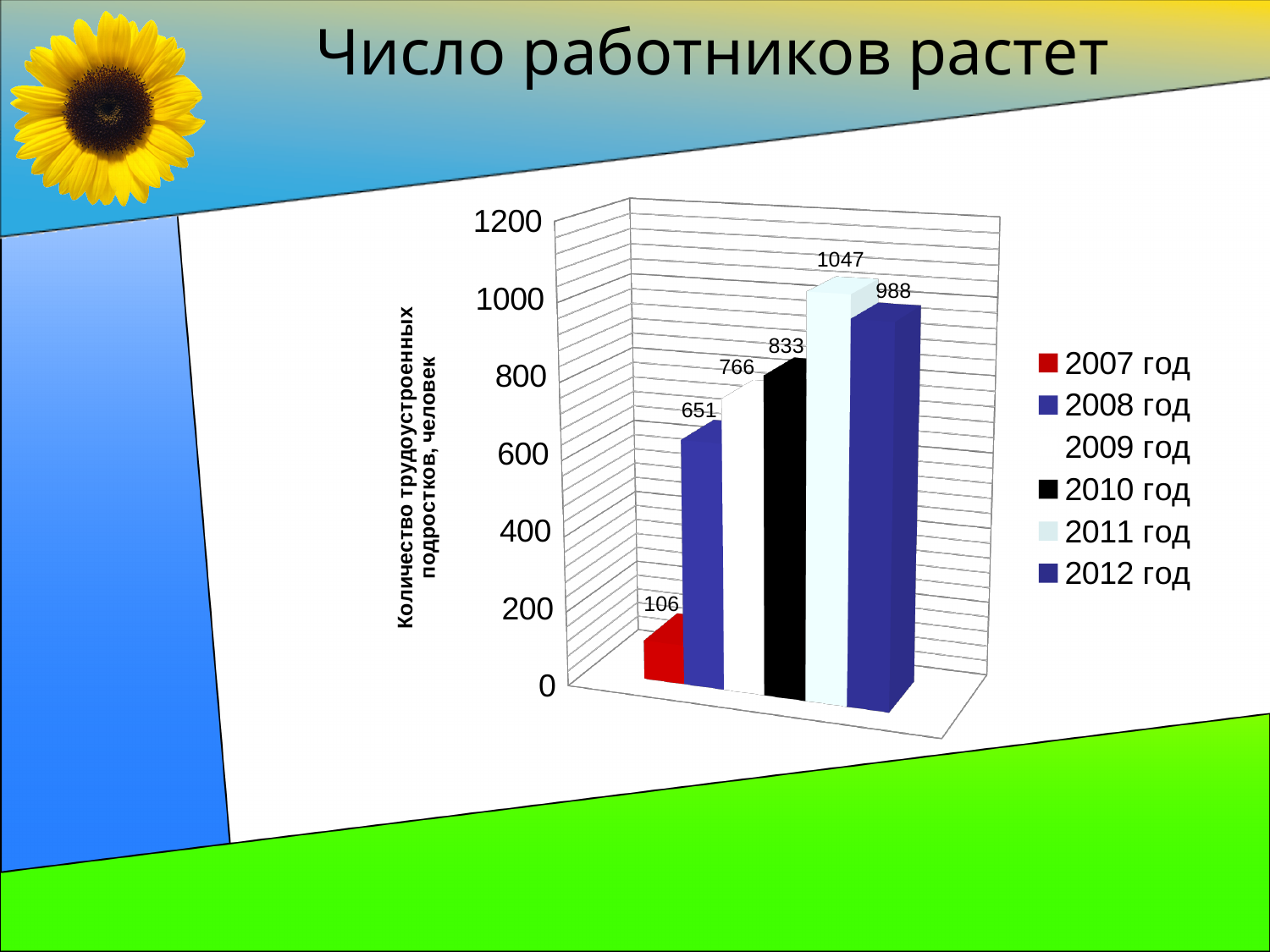
What kind of chart is shown on the slide? bar chart Is the value for 2010 год greater or less than 800? greater Which is larger, the value for 2010 год or the value for 2012 год? 2012 год Which year has the lowest value? 2007 год What is the value for 2009 год? 766 What colour is the bar for 2010 год? black What is the value for 2007 год? 106 What is the title of the slide? Число работников растет What is the value for 2011 год? 1047 What is the difference between the values for 2012 год and 2008 год? 337 Which year has the highest value? 2011 год How many series does the legend list? 6